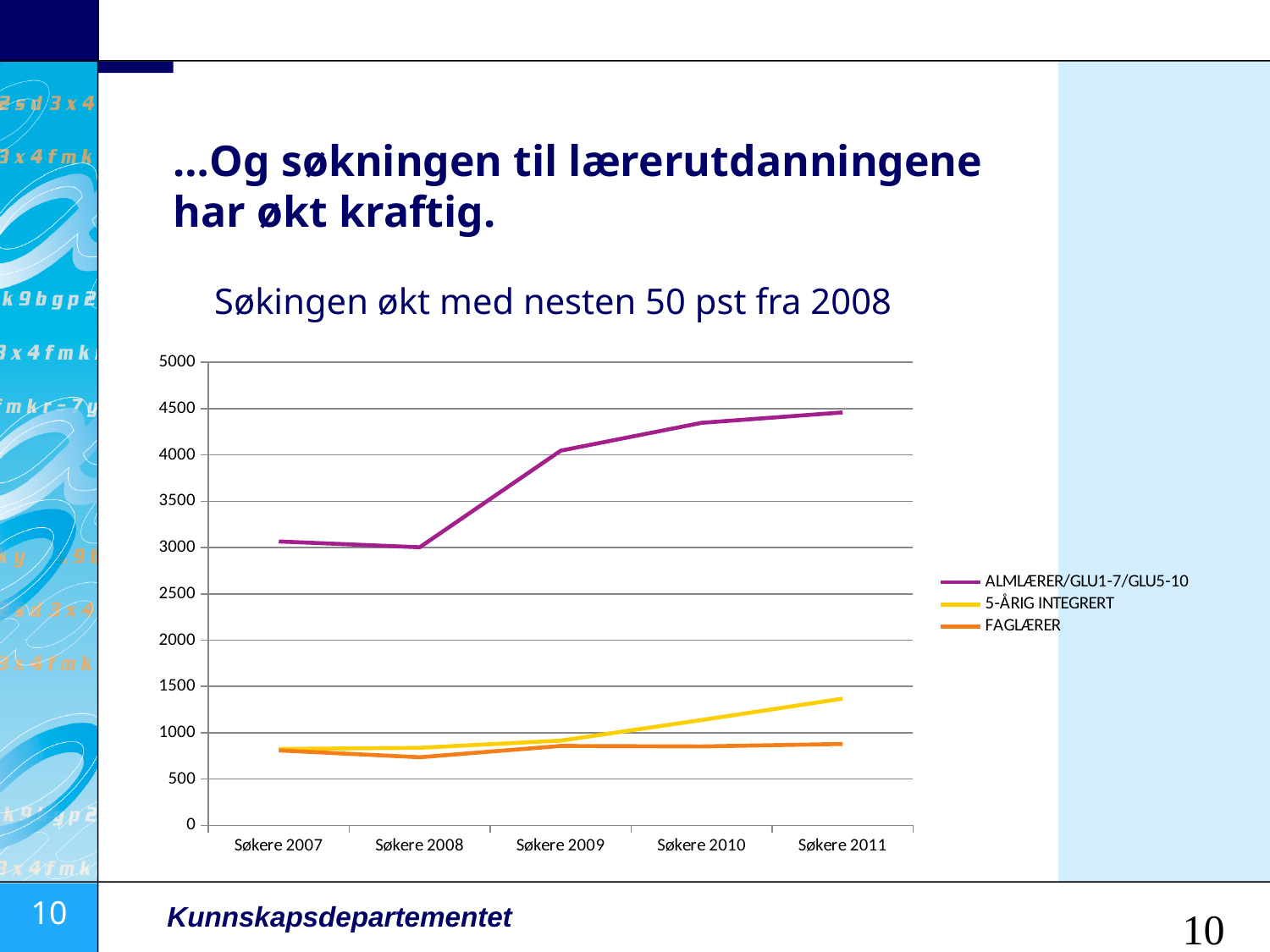
Does the ALMLÆRER/GLU1-7/GLU5-10 line rise or fall from Søkere 2008 to Søkere 2011? rise How many points along the x axis does each line have? 5 Which series has the highest value at Søkere 2011? ALMLÆRER/GLU1-7/GLU5-10 Is the value for ALMLÆRER/GLU1-7/GLU5-10 at Søkere 2010 greater or less than 4000? greater Is the value for 5-ÅRIG INTEGRERT at Søkere 2011 greater or less than 1000? greater At Søkere 2011, which is larger: 5-ÅRIG INTEGRERT or FAGLÆRER? 5-ÅRIG INTEGRERT What is the title of the chart? Søkingen økt med nesten 50 pst fra 2008 How many series does the legend list? 3 Is the value for ALMLÆRER/GLU1-7/GLU5-10 at Søkere 2010 greater or less than 4500? less Which series has the lowest value at Søkere 2011? FAGLÆRER What kind of chart is shown on the slide? line chart